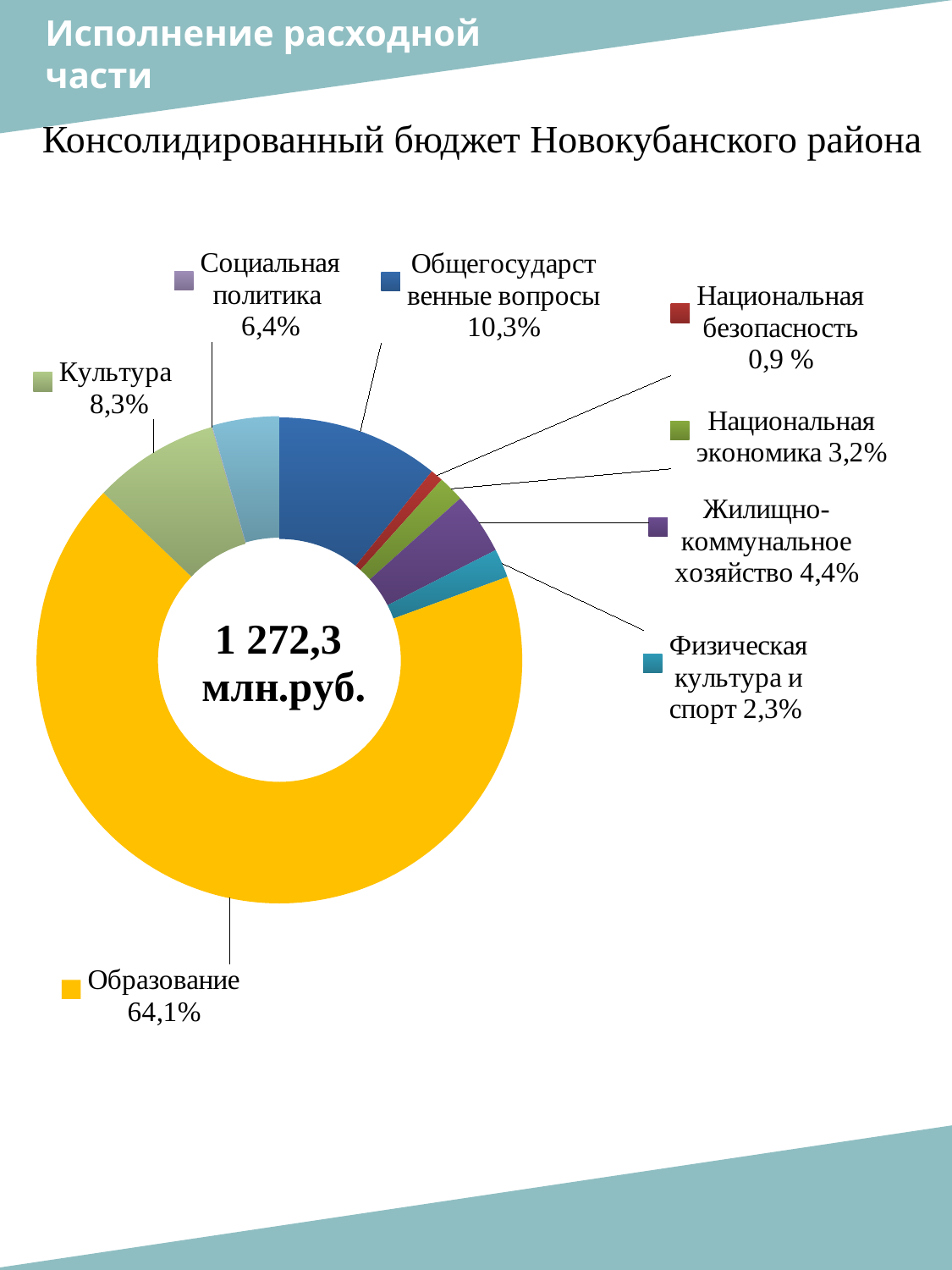
What share of the budget goes to Образование? 64,1% What colour is the Образование segment? Yellow Which category has the largest share of the budget? Образование What kind of chart is shown on the slide? Doughnut (pie) chart How many categories are shown in the chart? 8 What total amount is shown in the centre of the chart? 1 272,3 млн.руб. Which has a larger share: Социальная политика or Национальная экономика? Социальная политика What share of the budget goes to Общегосударственные вопросы? 10,3% What is the difference in percentage points between Общегосударственные вопросы and Культура? 2 percentage points Which category has the smallest share of the budget? Национальная безопасность What share of the budget goes to Культура? 8,3% What share of the budget goes to Жилищно-коммунальное хозяйство? 4,4%